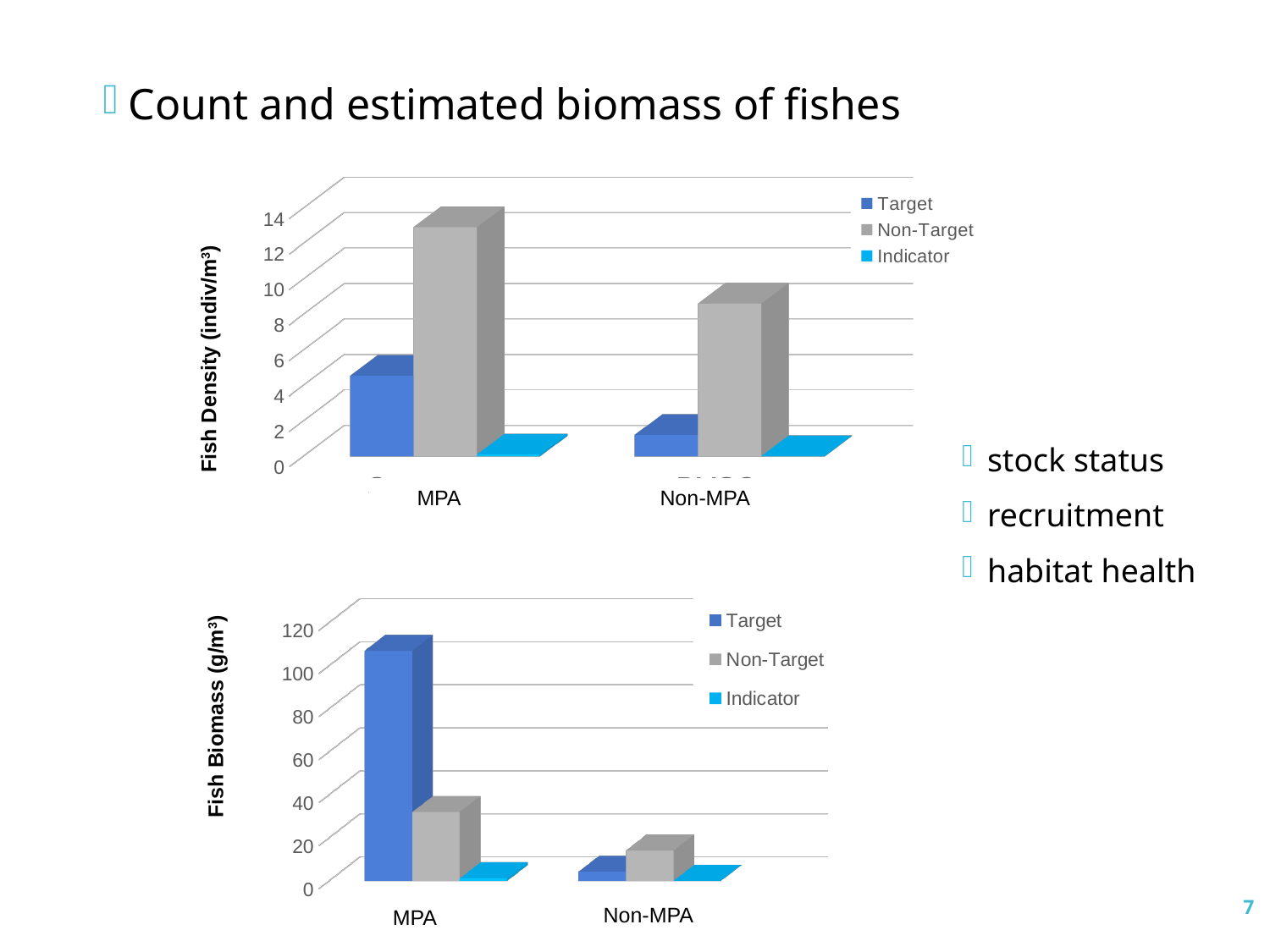
In the Fish Biomass chart (bottom), is the Non-Target value for Non-MPA greater or less than 40? less In the Fish Biomass chart (bottom), is the Non-Target value for MPA greater or less than 60? less What kind of chart is the Fish Biomass chart (bottom)? bar chart In the Fish Density chart (top), which series has the tallest bar for MPA? Non-Target In the Fish Biomass chart (bottom), which series has the tallest bar for MPA? Target In the Fish Density chart (top), is the Target value for Non-MPA greater or less than 2? less How many series does the legend of the Fish Biomass chart (bottom) list? 3 In the Fish Density chart (top), is the Non-Target value larger for MPA or for Non-MPA? MPA How many categories are shown on the x axis of the Fish Density chart (top)? 2